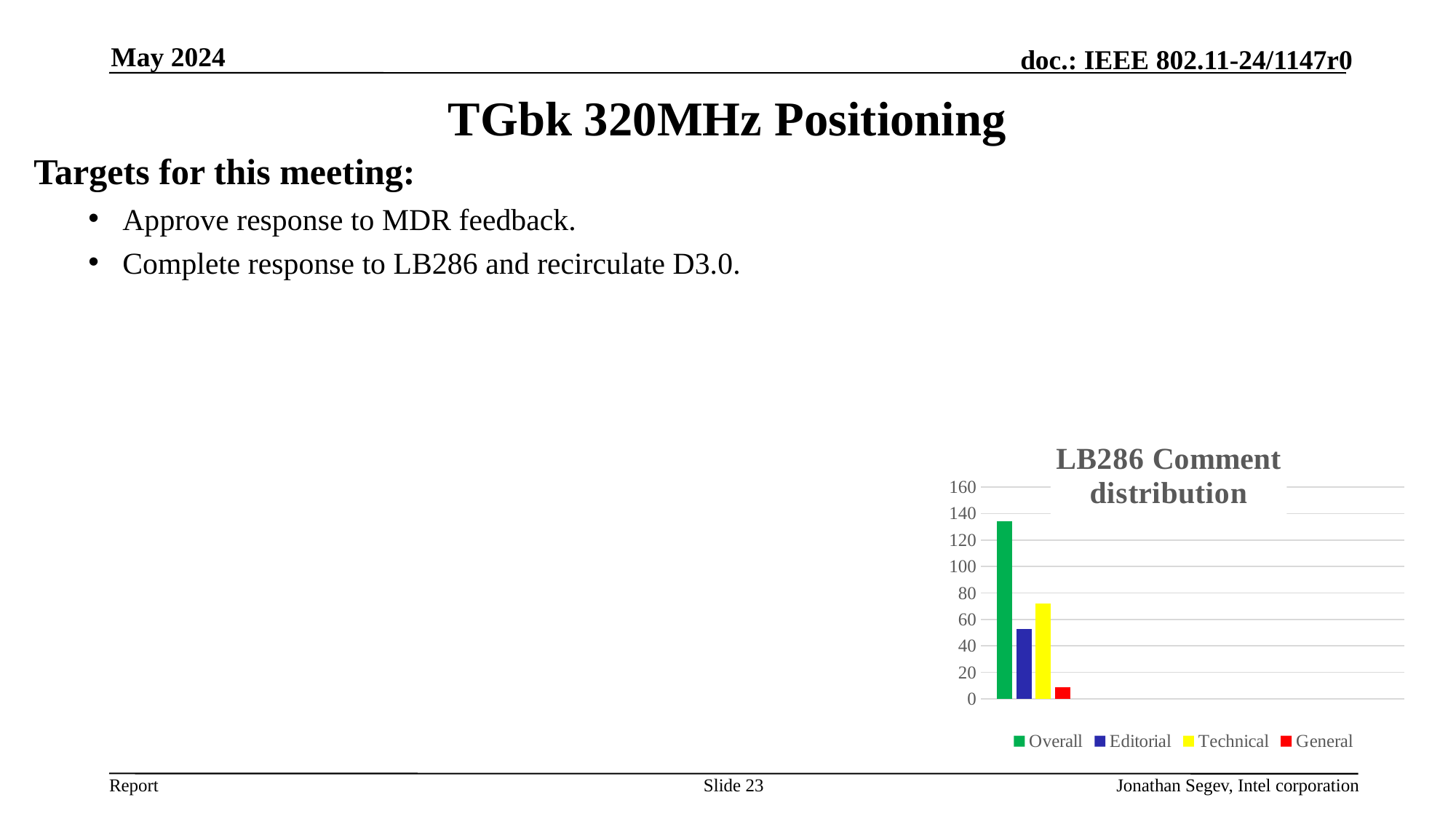
Is the value for Editorial greater or less than 60? less Which series has the lowest value in the chart? General What colour is the bar for the Technical series? yellow What is the title of the chart? LB286 Comment distribution Is the value for Technical greater or less than 60? greater Which is larger, the value for Editorial or the value for General? Editorial How many series does the chart's legend list? 4 Is the value for Overall greater or less than 120? greater Which series has the highest value in the chart? Overall What kind of chart is shown on the slide? bar chart Which is larger, the value for Technical or the value for Editorial? Technical